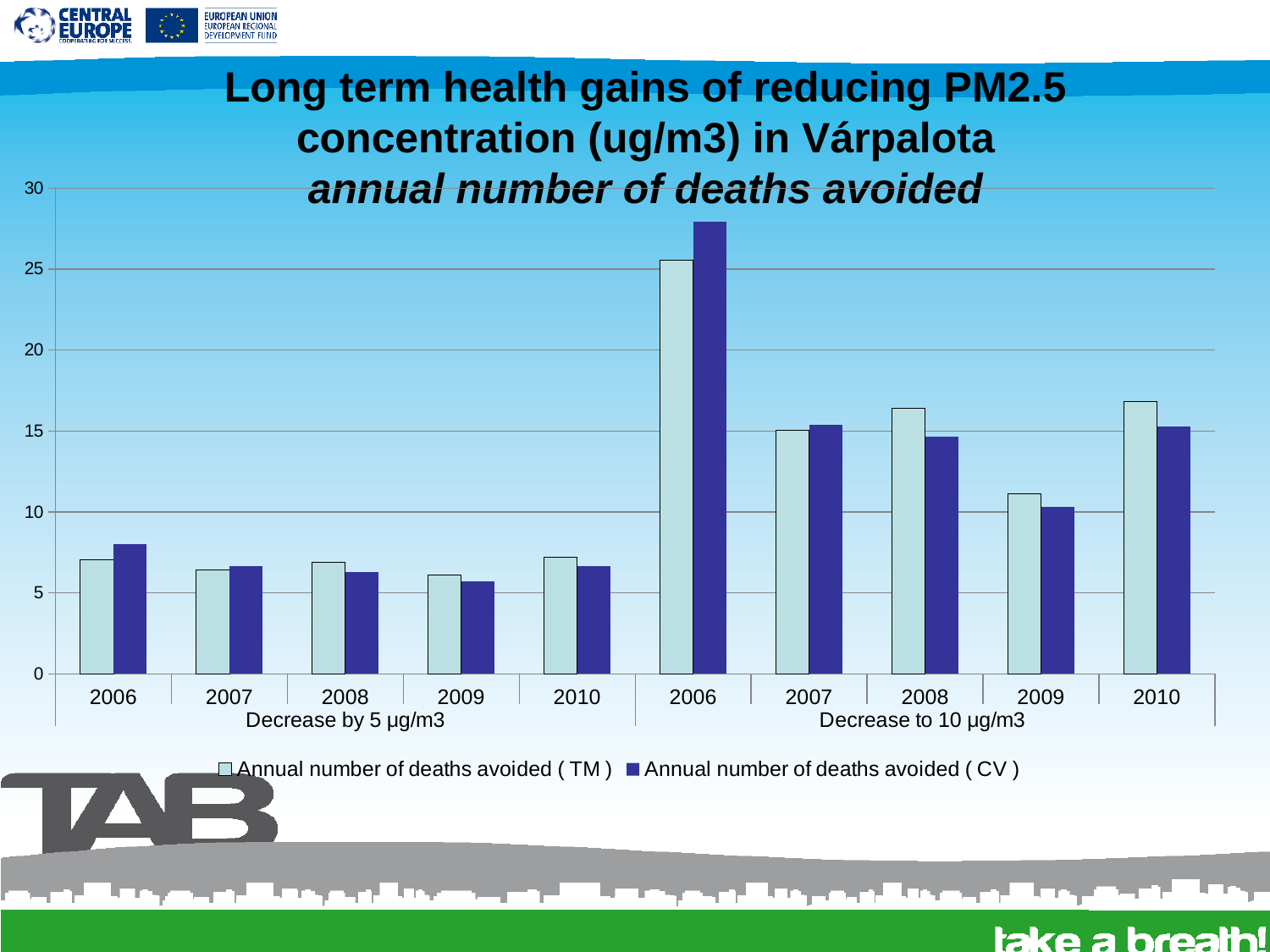
Which scenario group shows higher values overall: 'Decrease by 5 µg/m3' or 'Decrease to 10 µg/m3'? Decrease to 10 µg/m3 Which bar is the highest in the chart? Annual number of deaths avoided (CV), 2006, Decrease to 10 µg/m3 Is the value for Annual number of deaths avoided (TM) in 2006 under 'Decrease by 5 µg/m3' greater or less than 10? less Is the value for Annual number of deaths avoided (TM) in 2010 under 'Decrease to 10 µg/m3' greater or less than 15? greater Is the value for Annual number of deaths avoided (CV) in 2006 under 'Decrease to 10 µg/m3' greater or less than 25? greater How many series does the legend list? 2 How many year categories are plotted along the x axis in total? 10 Under 'Decrease to 10 µg/m3' in 2008, which is larger: Annual number of deaths avoided (TM) or Annual number of deaths avoided (CV)? Annual number of deaths avoided (TM) What kind of chart is shown on the slide? bar chart What colour are the bars for Annual number of deaths avoided (CV)? dark blue Under 'Decrease by 5 µg/m3' in 2006, which is larger: Annual number of deaths avoided (TM) or Annual number of deaths avoided (CV)? Annual number of deaths avoided (CV)